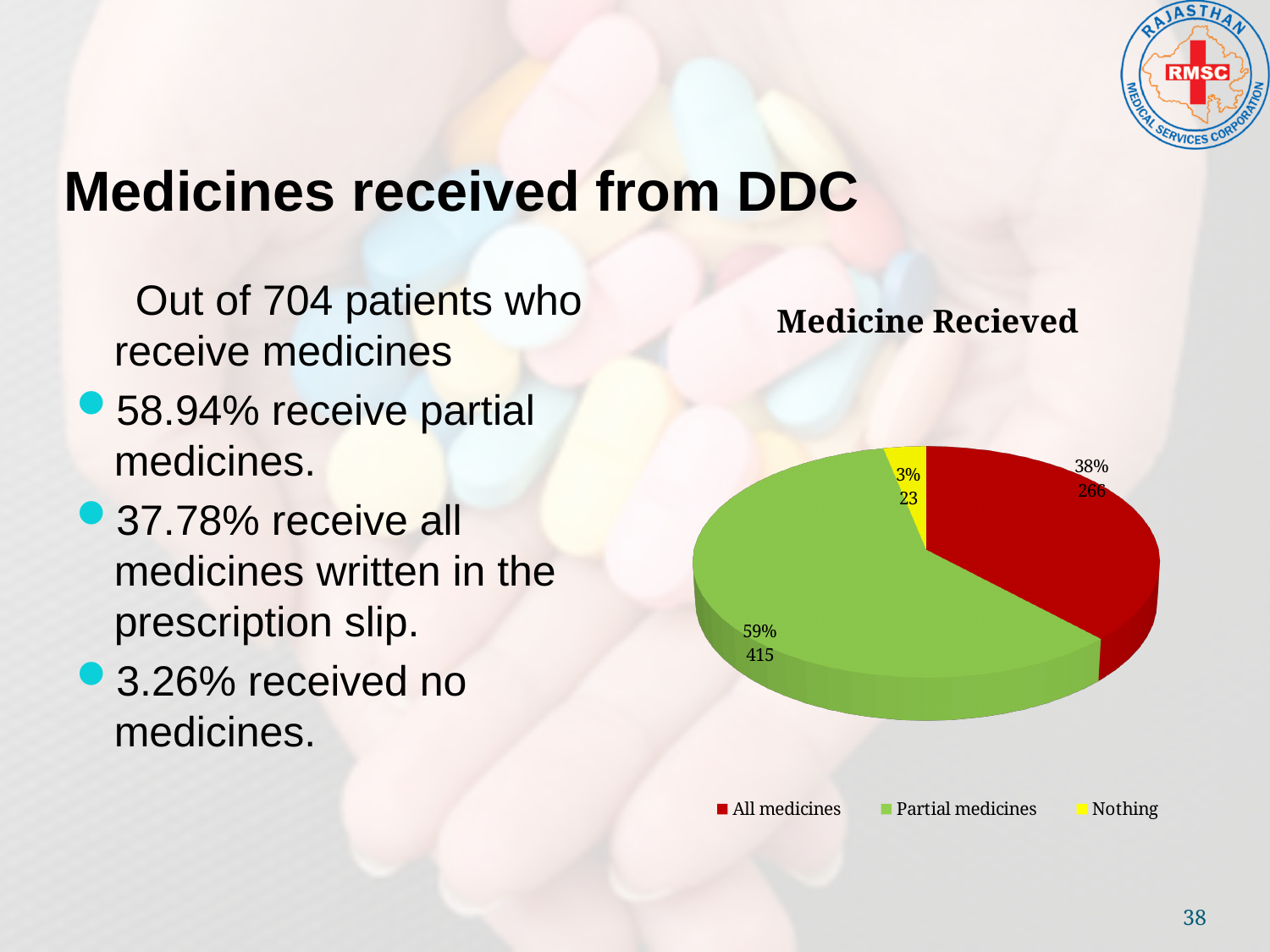
How many slices does the pie chart have? 3 What is the count shown for Nothing? 23 What percentage share does the Nothing slice have? 3% How many entries does the legend list? 3 What percentage share does the Partial medicines slice have? 59% What is the count shown for All medicines? 266 Which category has the largest slice? Partial medicines Which category has the smallest slice? Nothing What type of chart is shown on the slide? pie chart What is the title of the chart? Medicine Recieved What is the count shown for Partial medicines? 415 What is the difference between the counts for Partial medicines and All medicines? 149